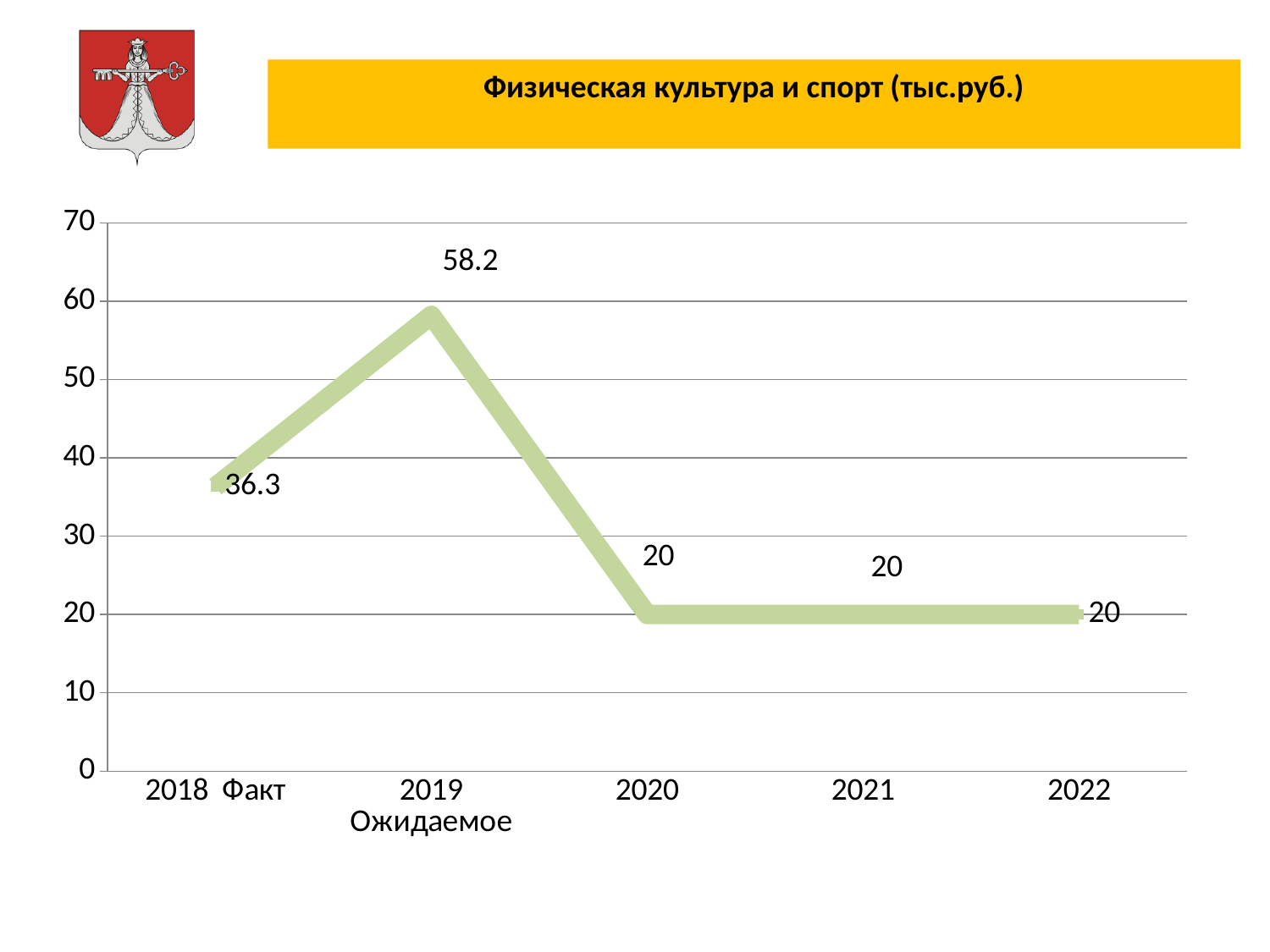
What is the value for 2021? 20 What is the title of the chart? Физическая культура и спорт (тыс.руб.) Which is larger, the value for 2018 Факт or the value for 2022? 2018 Факт What is the difference between the values for 2019 Ожидаемое and 2020? 38.2 Which year has the highest value? 2019 Ожидаемое What is the difference between the values for 2019 Ожидаемое and 2018 Факт? 21.9 What is the value for 2019 Ожидаемое? 58.2 What kind of chart is shown on the slide? line chart Do the values rise or fall from 2019 Ожидаемое to 2020? fall What is the value for 2018 Факт? 36.3 Is the value for 2019 Ожидаемое greater or less than 50? greater How many data points are plotted on the chart? 5